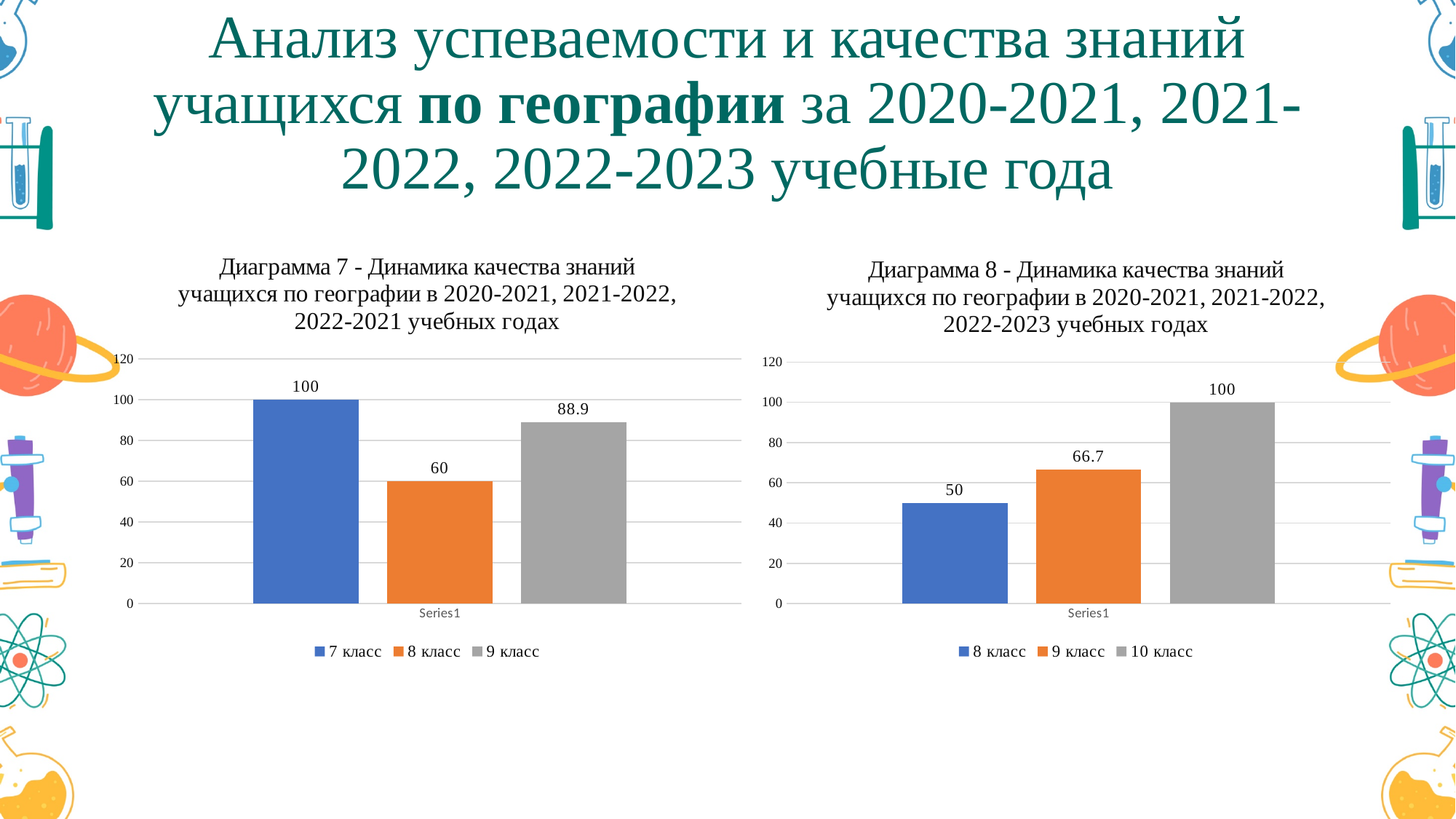
In Диаграмма 7 (left chart), how many series does the legend list? 3 In Диаграмма 8 (right chart), which class has the highest value? 10 класс In Диаграмма 7 (left chart), what is the value for 7 класс? 100 In Диаграмма 8 (right chart), what is the difference between the values for 10 класс and 9 класс? 33.3 In Диаграмма 8 (right chart), what colour is the bar for 10 класс? Gray In Диаграмма 8 (right chart), which is larger: the value for 8 класс or 9 класс? 9 класс What type of chart is Диаграмма 8 (right chart)? Bar chart In Диаграмма 7 (left chart), what is the difference between the values for 7 класс and 8 класс? 40 In Диаграмма 7 (left chart), which class has the lowest value? 8 класс In Диаграмма 8 (right chart), what is the value for 8 класс? 50 In Диаграмма 7 (left chart), what is the value for 9 класс? 88.9 In Диаграмма 8 (right chart), what is the value for 9 класс? 66.7